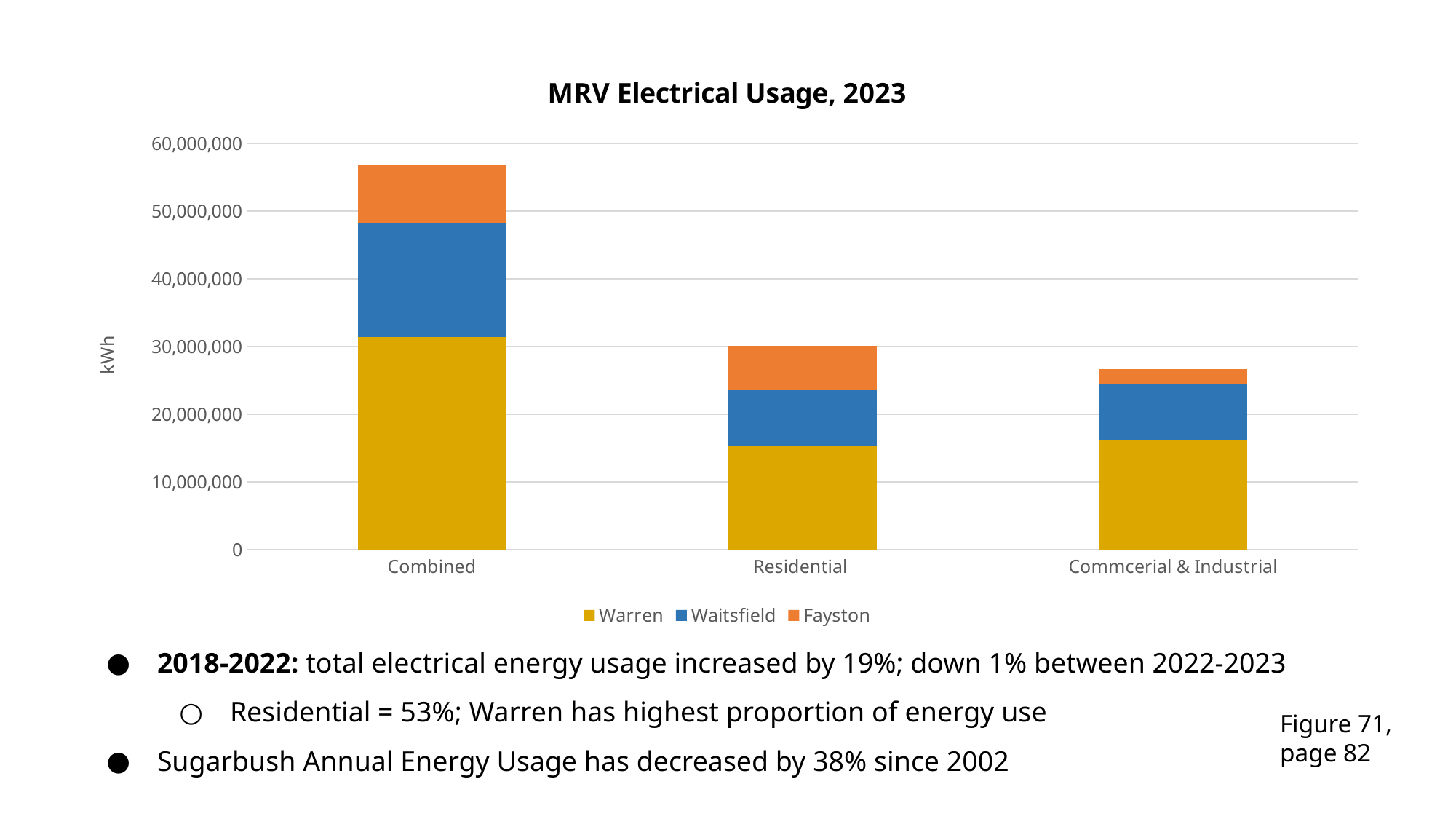
What is the title of the chart? MRV Electrical Usage, 2023 In the Combined bar, which segment is larger, Warren or Fayston? Warren Which category has the shortest stacked bar? Commcerial & Industrial Is the total of the Combined bar greater or less than 50,000,000? greater What kind of chart is shown on the slide? Stacked bar chart What unit is shown on the y axis label? kWh Which stacked bar is taller, Residential or Commcerial & Industrial? Residential How many categories are shown on the x axis? 3 Is the Warren segment of the Combined bar greater or less than 20,000,000? greater Which category has the tallest stacked bar? Combined Is the total of the Commcerial & Industrial bar greater or less than 30,000,000? less How many series does the legend list? 3